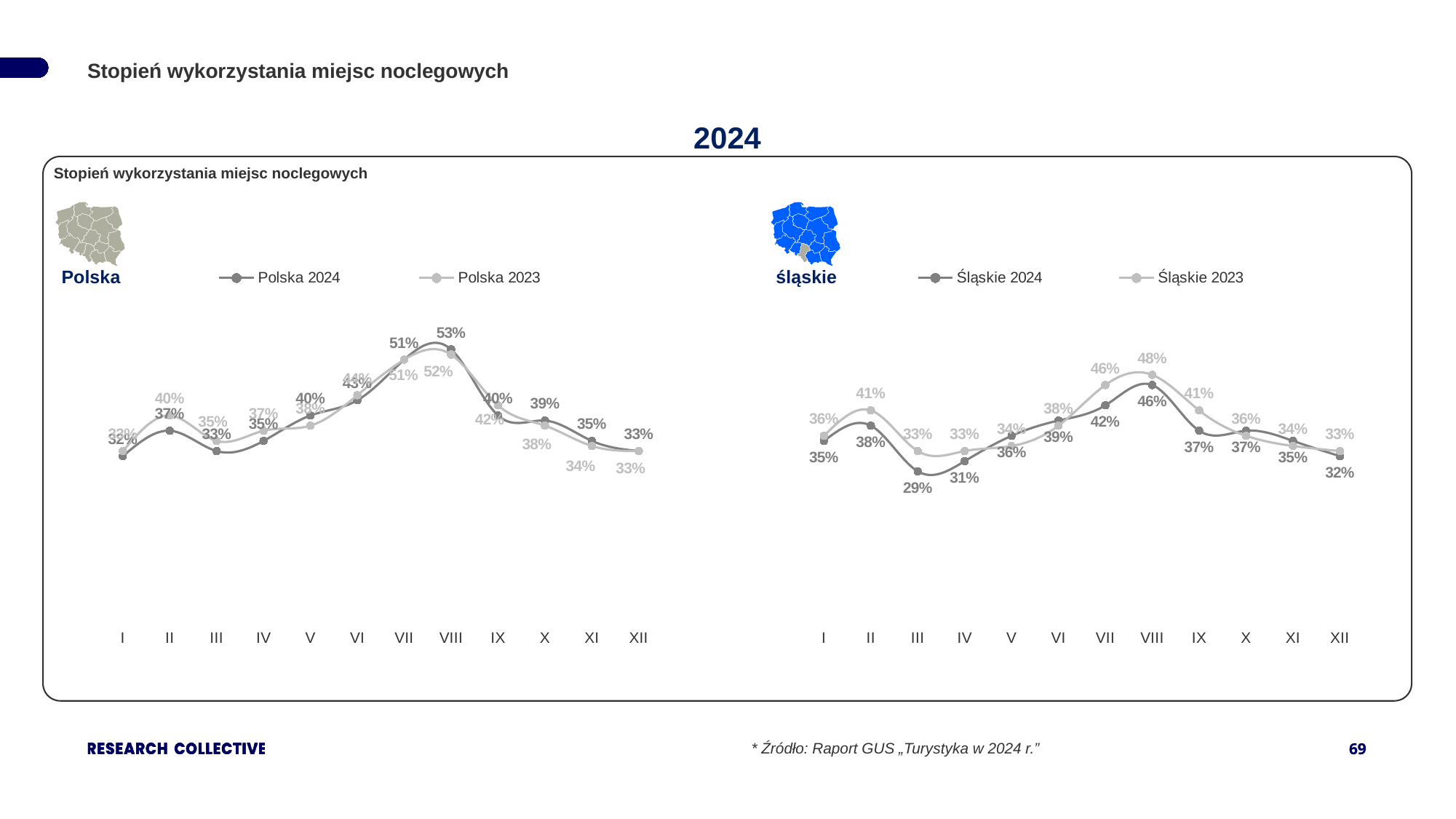
In the Śląskie chart, what is the value for Śląskie 2023 in month VIII? 48% How many months are shown on the x axis of the Polska chart? 12 What type of chart is the Polska chart? Line chart In the Polska chart, does the Polska 2024 line rise or fall from month VIII to month XII? Fall In the Śląskie chart, what is the value for Śląskie 2024 in month III? 29% In the Polska chart, which month has the highest value for Polska 2024? VIII In the Śląskie chart, which is larger in month IX: Śląskie 2024 or Śląskie 2023? Śląskie 2023 In the Śląskie chart, which month has the lowest value for Śląskie 2024? III In the Polska chart, what is the value for Polska 2024 in month VIII? 53% In the Polska chart, which is larger in month II: Polska 2024 or Polska 2023? Polska 2023 How many series does the legend of the Śląskie chart list? 2 In the Śląskie chart, what is the difference between Śląskie 2023 and Śląskie 2024 in month VII? 4%